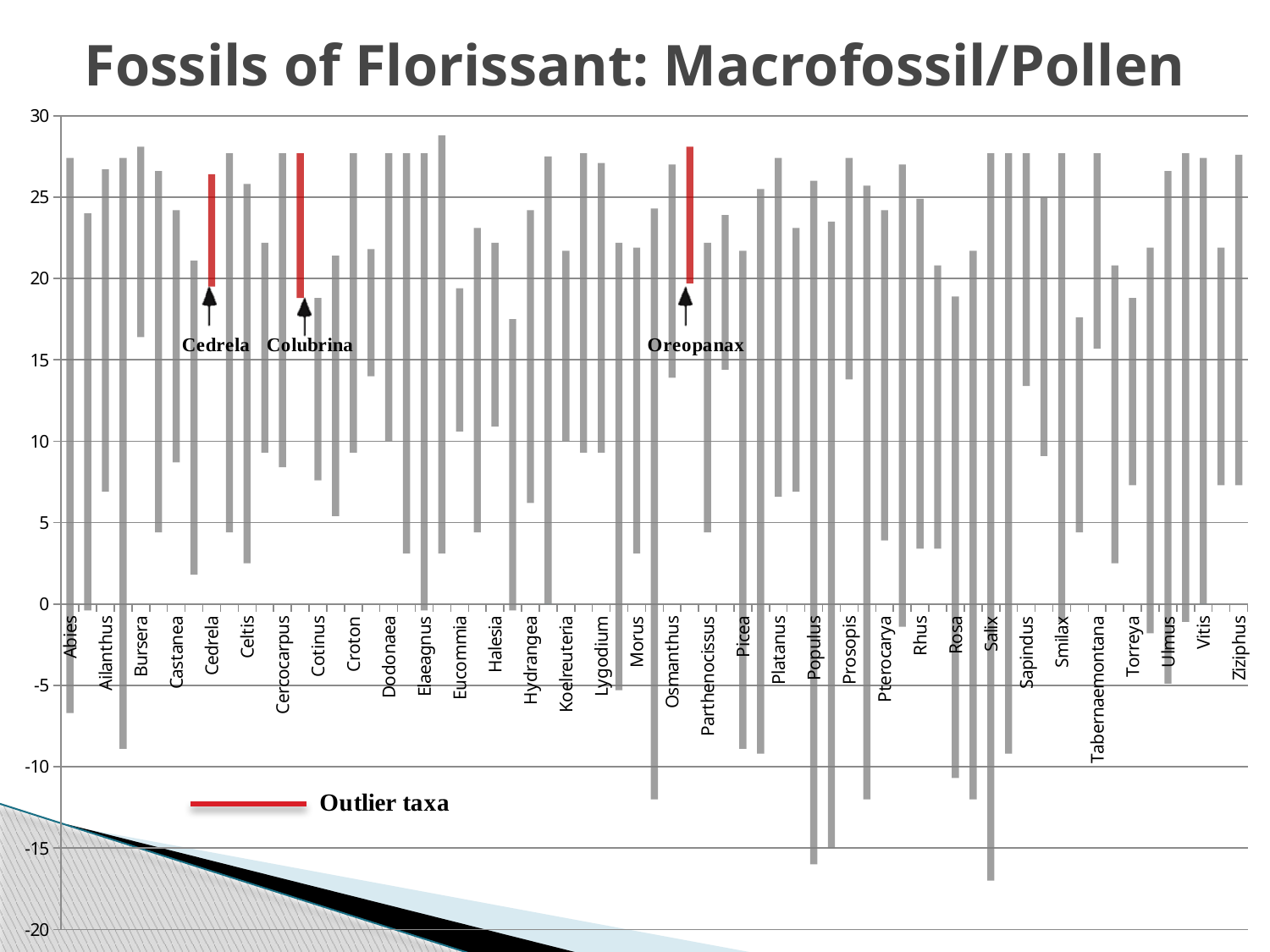
How many taxa are marked as outlier taxa with red bars? 3 Is the bottom of the red bar for Colubrina greater or less than 15? greater What is the title of the chart? Fossils of Florissant: Macrofossil/Pollen Which taxon is listed last on the x axis? Ziziphus What is the highest value shown on the y axis? 30 Is the top of the red bar for Cedrela greater or less than 25? greater Which taxa are highlighted in red as outlier taxa? Cedrela, Colubrina, Oreopanax Is the top of the red bar for Oreopanax greater or less than 25? greater What is the lowest value shown on the y axis? -20 What kind of chart is shown on the slide? bar chart Which taxon is listed first on the x axis? Abies How many taxa are labelled along the x axis of the chart? 34